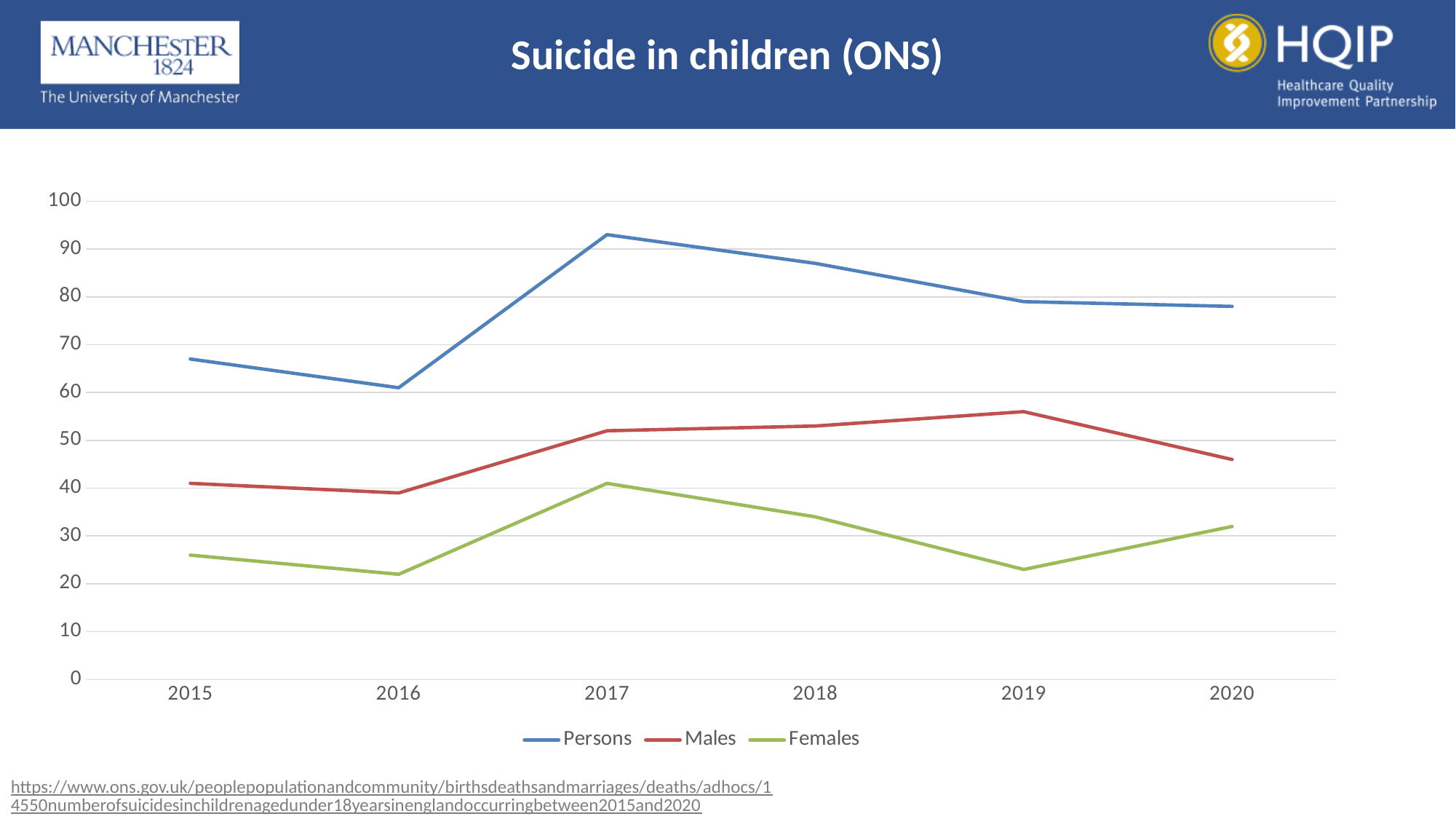
How many series does the legend list? 3 What kind of chart is shown on the slide? Line chart Is the value for Persons in 2016 greater or less than 70? less Does the Persons line rise or fall from 2017 to 2020? Fall Is the value for Males in 2019 greater or less than 50? greater Is the value for Females in 2019 greater or less than 30? less In which year is the Persons line at its highest? 2017 How many years are shown on the x axis? 6 What is the title of the chart? Suicide in children (ONS) Which is larger, the Females value in 2017 or the Females value in 2019? 2017 In which year is the Persons line at its lowest? 2016